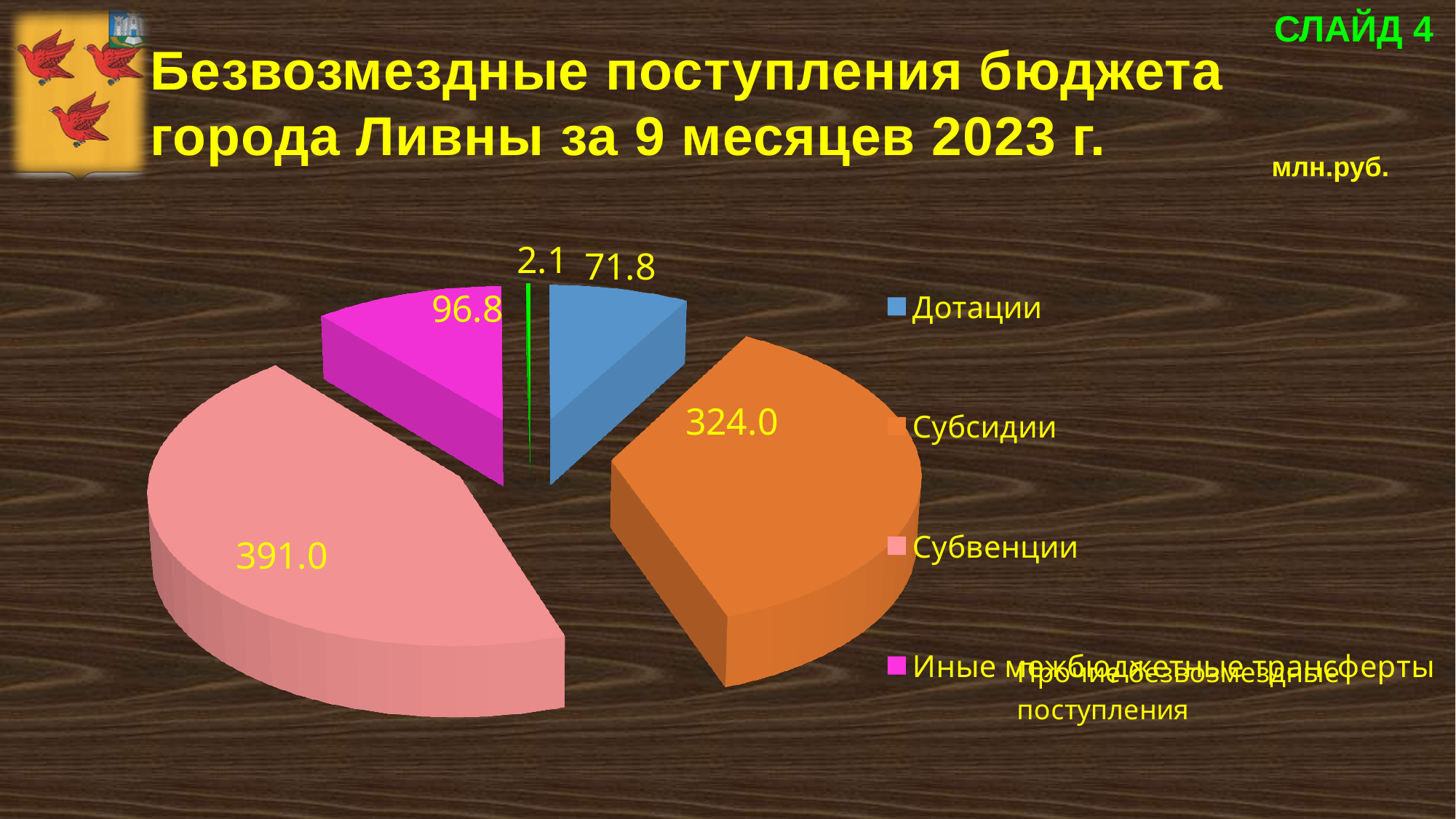
How many slices does the pie chart have? 5 What is the value for Иные межбюджетные трансферты on the pie chart? 96.8 What kind of chart is shown on the slide? pie chart Which is larger: Дотации or Иные межбюджетные трансферты? Иные межбюджетные трансферты What is the difference between the values for Субвенции and Субсидии? 67.0 What is the value for Дотации on the pie chart? 71.8 What is the value for Субвенции on the pie chart? 391.0 Which category has the largest slice of the pie chart? Субвенции What unit of measurement is indicated for the chart values? млн.руб. What is the sum of all the values labelled on the pie chart? 885.7 What is the smallest value labelled on the pie chart? 2.1 What is the value for Субсидии on the pie chart? 324.0